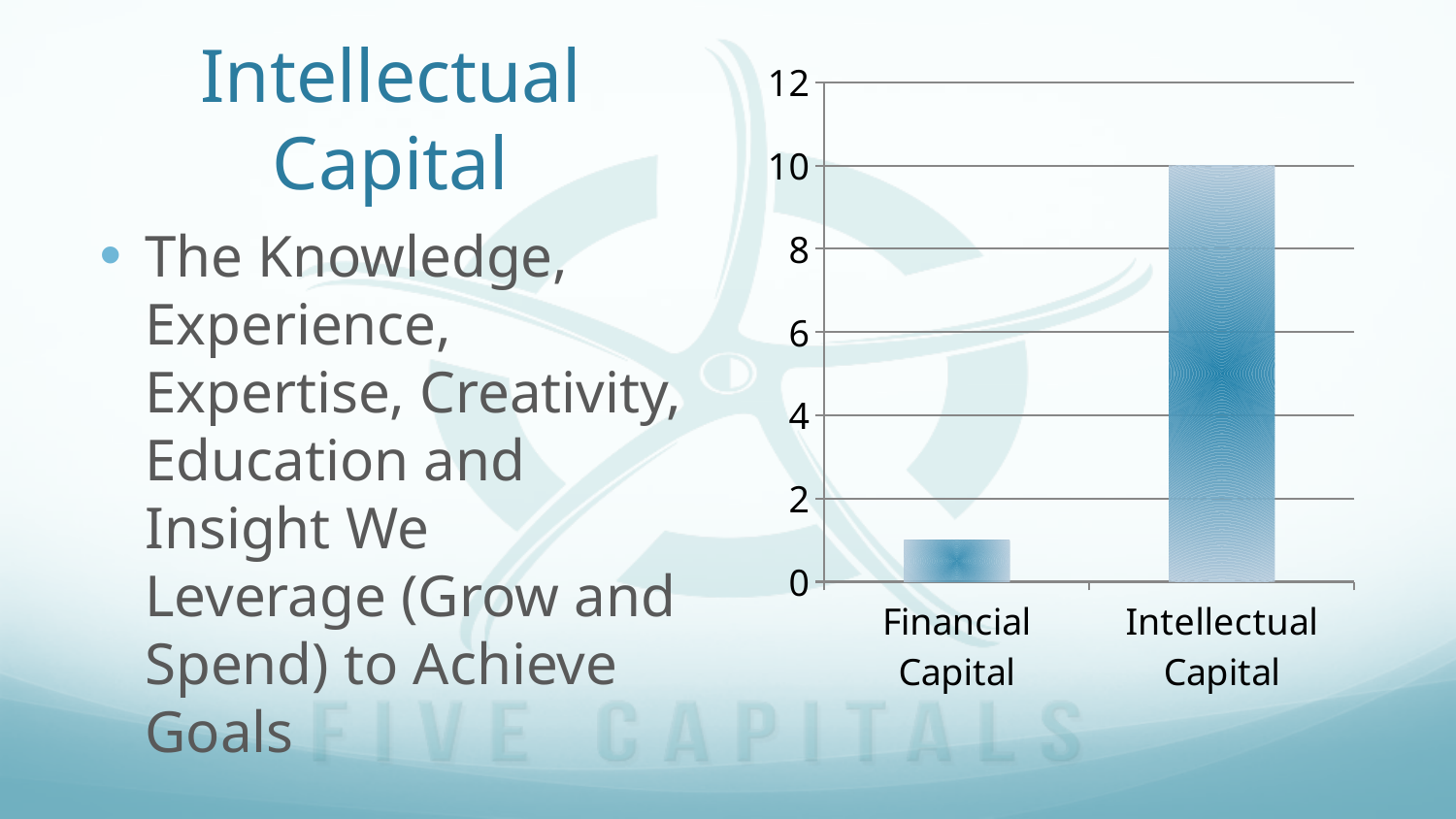
Is the value for Financial Capital greater or less than 2? less What kind of chart is shown on the slide? bar chart What is the value for Intellectual Capital in the chart? 10 Which category has the highest value in the chart? Intellectual Capital Is the value for Financial Capital greater or less than 4? less Is the value for Intellectual Capital greater or less than 8? greater Do the values rise or fall from left to right across the categories? rise What is the interval between tick marks on the vertical axis of the chart? 2 What is the highest tick value shown on the vertical axis of the chart? 12 How many categories are plotted in the chart? 2 Which category has the lowest value in the chart? Financial Capital Which is larger, the value for Financial Capital or the value for Intellectual Capital? Intellectual Capital